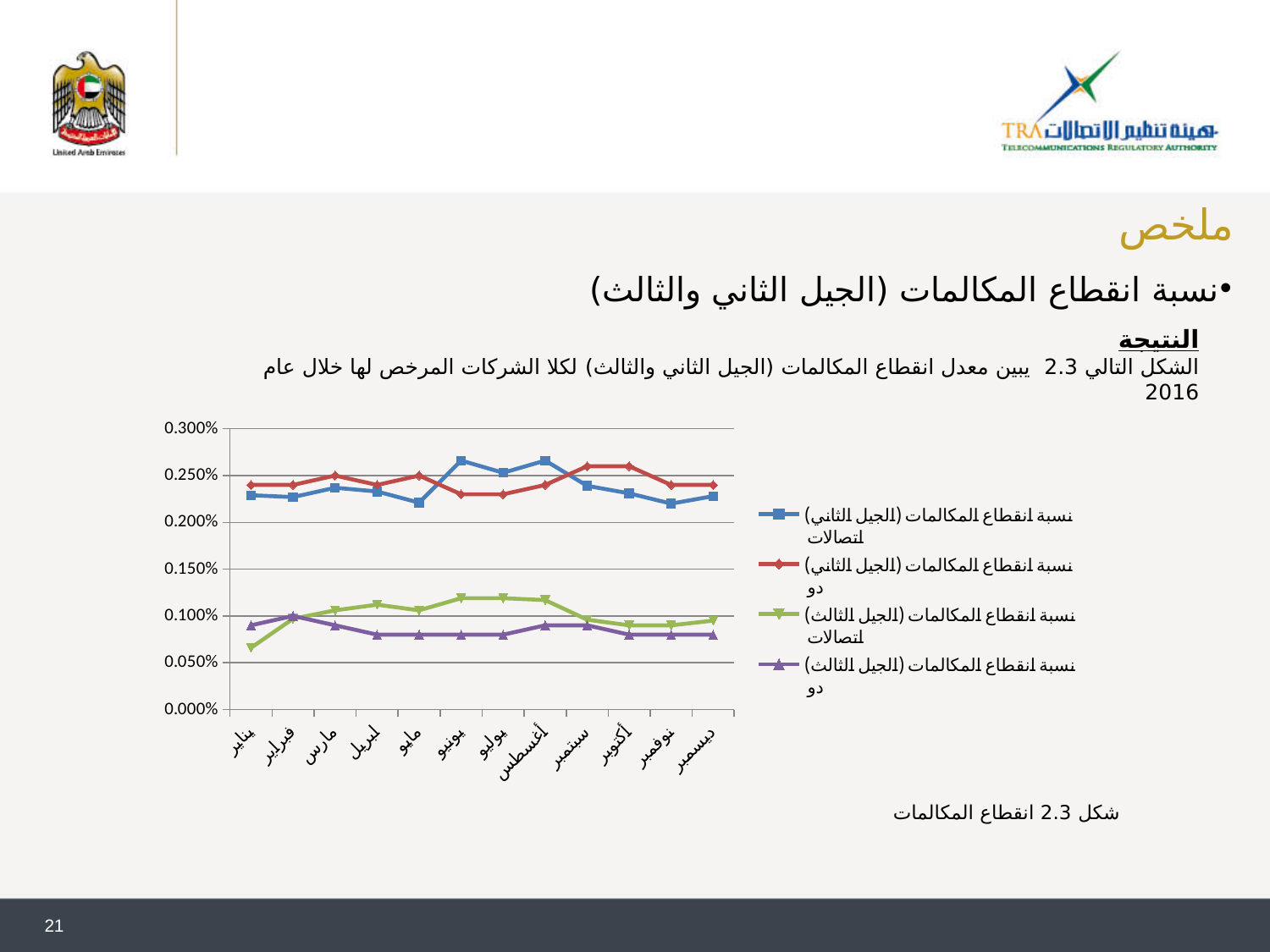
In which month is نسبة انقطاع المكالمات (الجيل الثالث) اتصالات at its lowest? يناير Is the value for نسبة انقطاع المكالمات (الجيل الثاني) اتصالات in يونيو greater or less than 0.250%? greater In يونيو, which is higher: نسبة انقطاع المكالمات (الجيل الثاني) اتصالات or نسبة انقطاع المكالمات (الجيل الثاني) دو? نسبة انقطاع المكالمات (الجيل الثاني) اتصالات What kind of chart is shown on the slide? line chart Does نسبة انقطاع المكالمات (الجيل الثالث) اتصالات rise or fall from يناير to مارس? rise How many months are shown along the x axis? 12 How many series does the legend list? 4 Is the value for نسبة انقطاع المكالمات (الجيل الثالث) اتصالات in يونيو greater or less than 0.100%? greater Is the value for نسبة انقطاع المكالمات (الجيل الثالث) اتصالات in يناير greater or less than 0.100%? less In يناير, which is higher: نسبة انقطاع المكالمات (الجيل الثالث) اتصالات or نسبة انقطاع المكالمات (الجيل الثالث) دو? نسبة انقطاع المكالمات (الجيل الثالث) دو What is the figure caption shown below the chart? شكل 2.3 انقطاع المكالمات